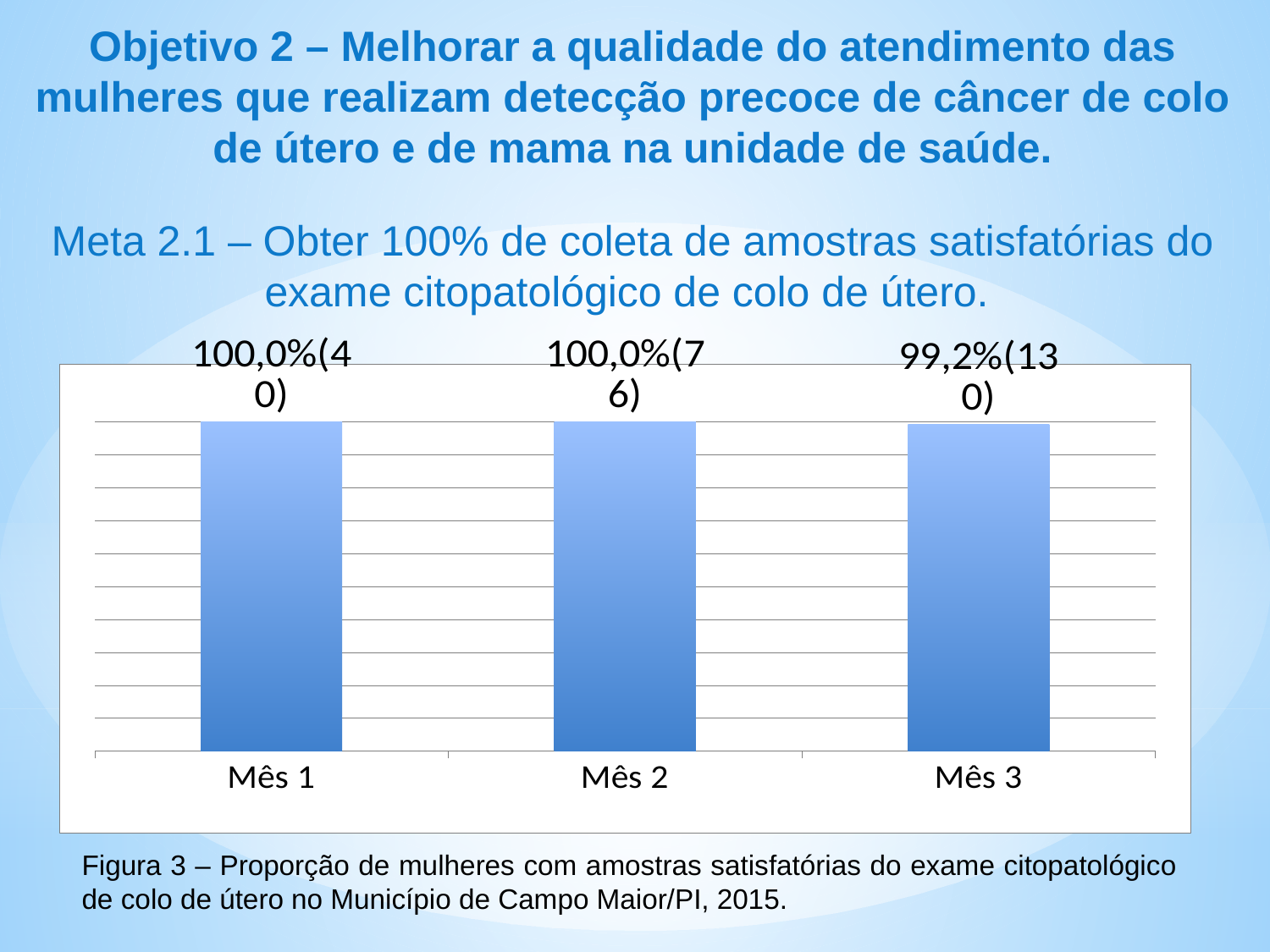
What percentage is shown for Mês 3? 99,2% What is the value shown for Mês 2? 100,0%(76) What is the value shown for Mês 3? 99,2%(130) What figure number is given in the caption below the chart? Figura 3 Which is larger, the percentage for Mês 1 or for Mês 3? Mês 1 How many women are indicated in parentheses for Mês 2? 76 How many categories (months) are plotted in the chart? 3 Which month has the lowest percentage? Mês 3 What type of chart is shown on the slide? bar chart What is the value shown for Mês 1? 100,0%(40) How many women are indicated in parentheses for Mês 3? 130 What is the difference in percentage points between Mês 2 and Mês 3? 0,8%